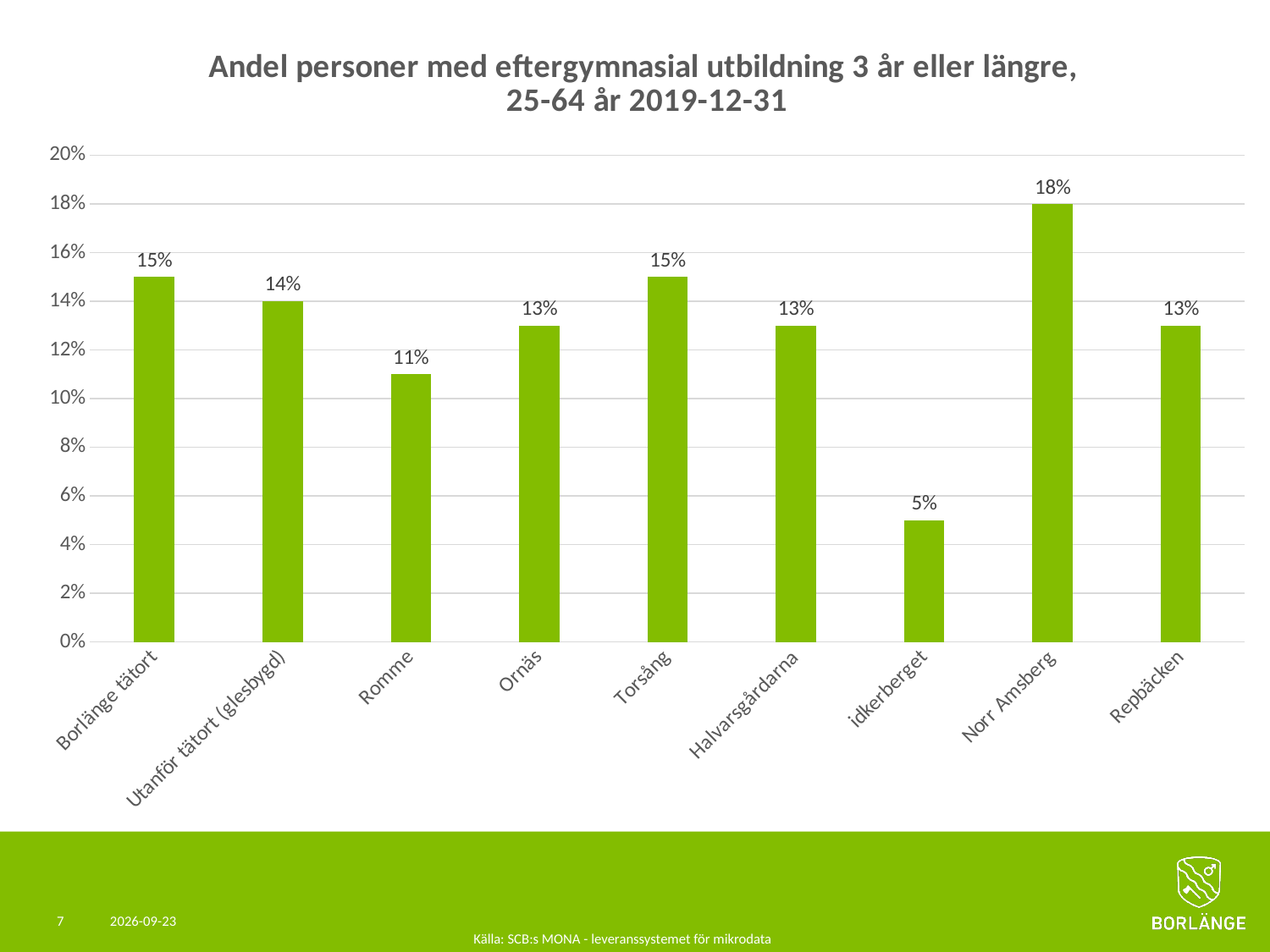
Which is larger, the value for Borlänge tätort or the value for Romme? Borlänge tätort What is the value for Utanför tätort (glesbygd)? 14% Is the value for Torsång greater or less than 10%? greater What is the difference between the values for Norr Amsberg and Idkerberget? 13% What is the value for Romme? 11% What is the value for Norr Amsberg? 18% What is the value for Idkerberget? 5% What is the source cited at the bottom of the slide? SCB:s MONA - leveranssystemet för mikrodata What kind of chart is shown on the slide? Bar chart How many categories are shown on the x axis? 9 Which category has the lowest value? Idkerberget Which category has the highest value? Norr Amsberg